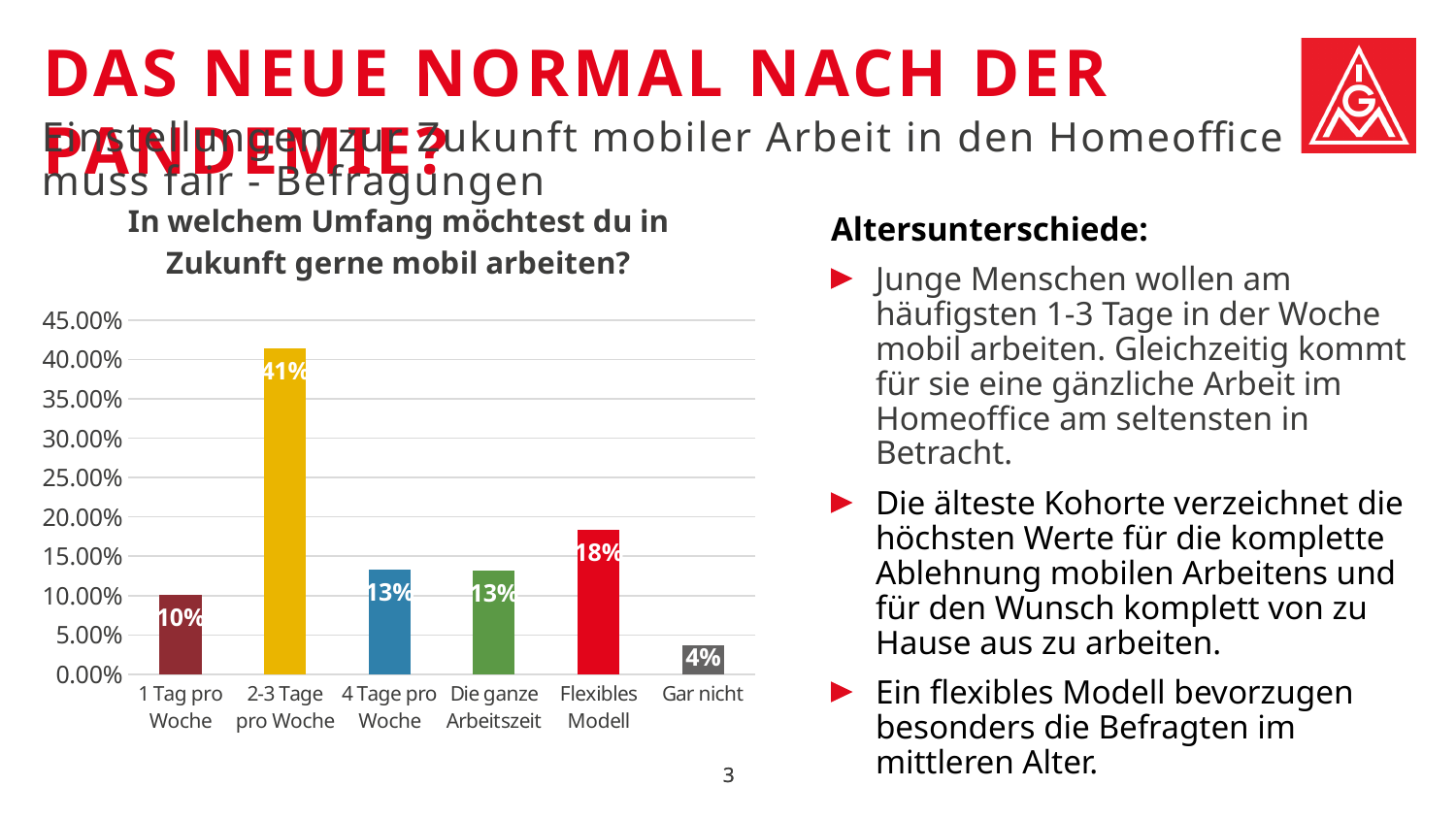
What is the difference between the values for "2-3 Tage pro Woche" and "1 Tag pro Woche"? 31% What is the difference between the values for "Flexibles Modell" and "Gar nicht"? 14% Which is larger, the value for "Flexibles Modell" or the value for "4 Tage pro Woche"? Flexibles Modell What is the value for "2-3 Tage pro Woche"? 41% Is the value for "2-3 Tage pro Woche" greater or less than 35.00%? greater What is the value for "Gar nicht"? 4% What kind of chart is shown on the slide? bar chart Which category has the lowest value? Gar nicht What is the value for "Flexibles Modell"? 18% What is the value for "1 Tag pro Woche"? 10% How many categories are shown on the x axis? 6 Which category has the highest value? 2-3 Tage pro Woche